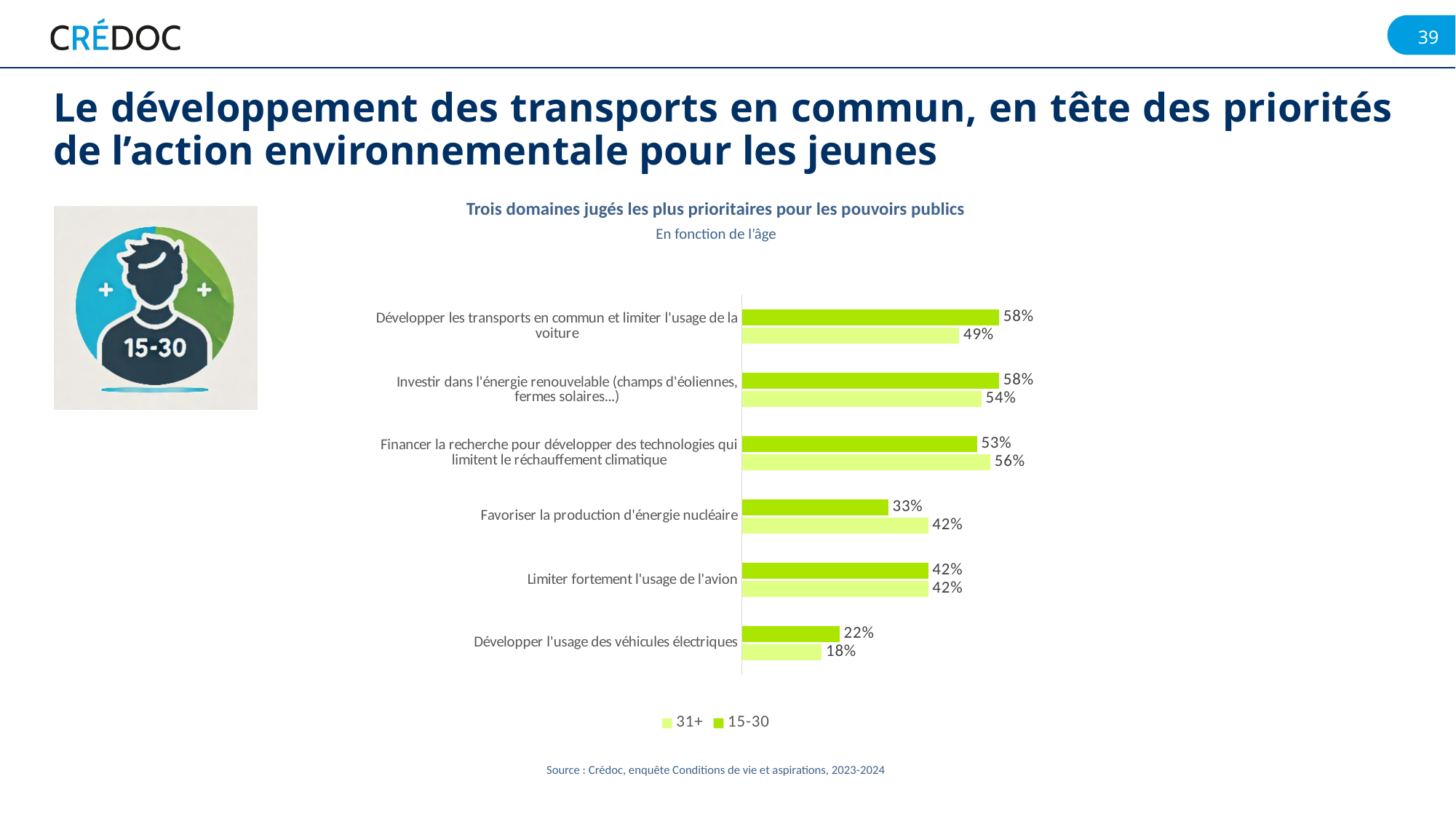
What is the title of the chart? Trois domaines jugés les plus prioritaires pour les pouvoirs publics What is the value for the 31+ series for 'Financer la recherche pour développer des technologies qui limitent le réchauffement climatique'? 56% For 'Favoriser la production d'énergie nucléaire', which series has the larger value, 15-30 or 31+? 31+ Which category has the lowest value for the 15-30 series? Développer l'usage des véhicules électriques What is the value for the 15-30 series for 'Développer les transports en commun et limiter l'usage de la voiture'? 58% What kind of chart is shown on the slide? bar chart What is the difference between the 15-30 and 31+ values for 'Développer l'usage des véhicules électriques'? 4 percentage points How many series does the legend list? 2 What is the value for the 31+ series for 'Favoriser la production d'énergie nucléaire'? 42% How many categories are shown in the chart? 6 What is the difference between the 15-30 and 31+ values for 'Développer les transports en commun et limiter l'usage de la voiture'? 9 percentage points Which category has the highest value for the 31+ series? Financer la recherche pour développer des technologies qui limitent le réchauffement climatique